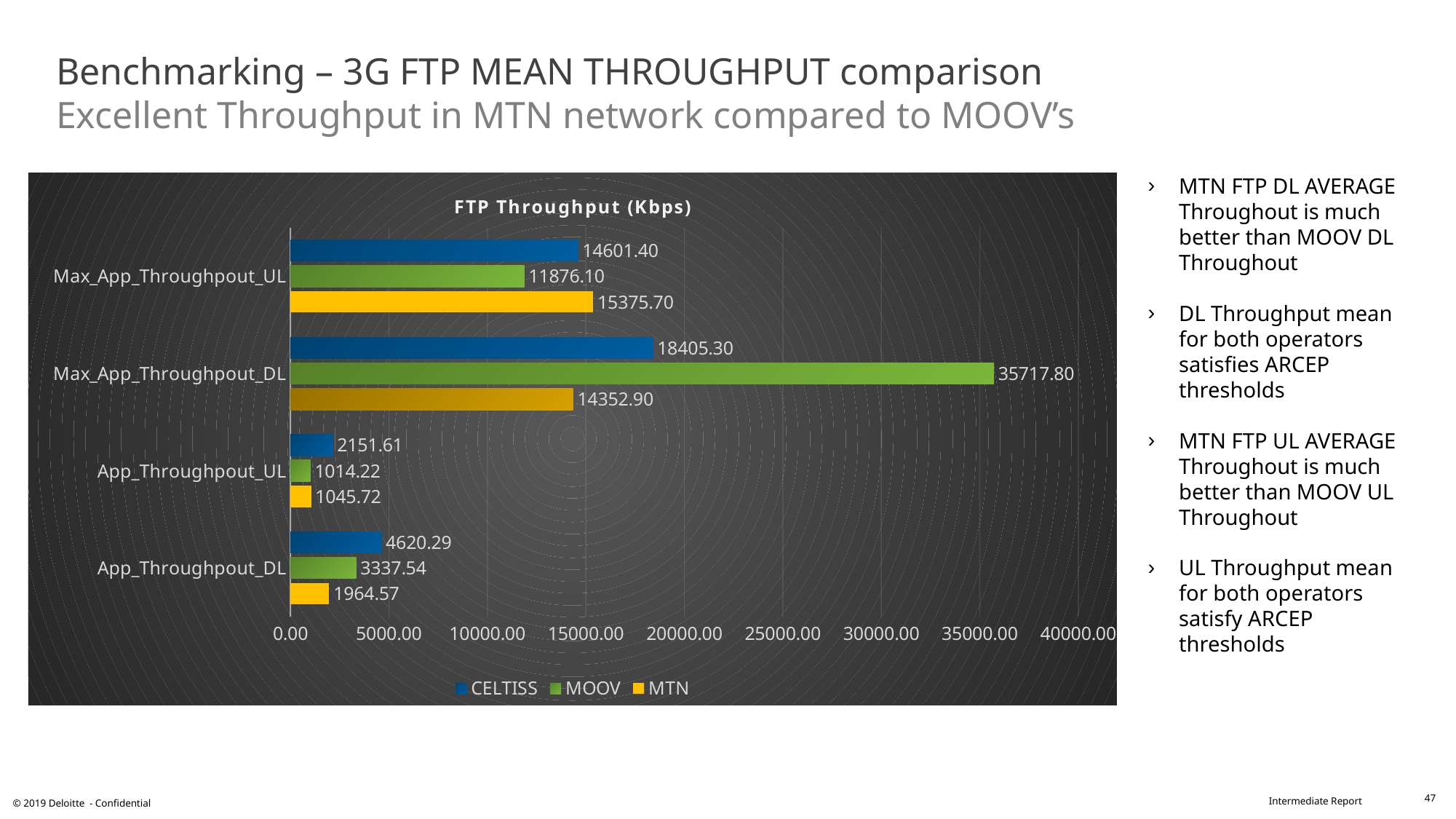
How many series does the legend list? 3 What is the MTN value for App_Throughpout_UL? 1045.72 What is the difference between the MOOV and CELTISS values for Max_App_Throughpout_DL? 17312.50 What is the difference between the MTN and MOOV values for Max_App_Throughpout_UL? 3499.60 Which series has the lowest value for App_Throughpout_DL? MTN How many categories are shown on the chart? 4 Which is larger for App_Throughpout_DL, the CELTISS value or the MOOV value? CELTISS Is the MOOV value for Max_App_Throughpout_DL greater or less than 30000.00? greater What is the MOOV value for Max_App_Throughpout_UL? 11876.10 What type of chart is shown on the slide? Bar chart What is the CELTISS value for Max_App_Throughpout_DL? 18405.30 Which series has the highest value for Max_App_Throughpout_DL? MOOV